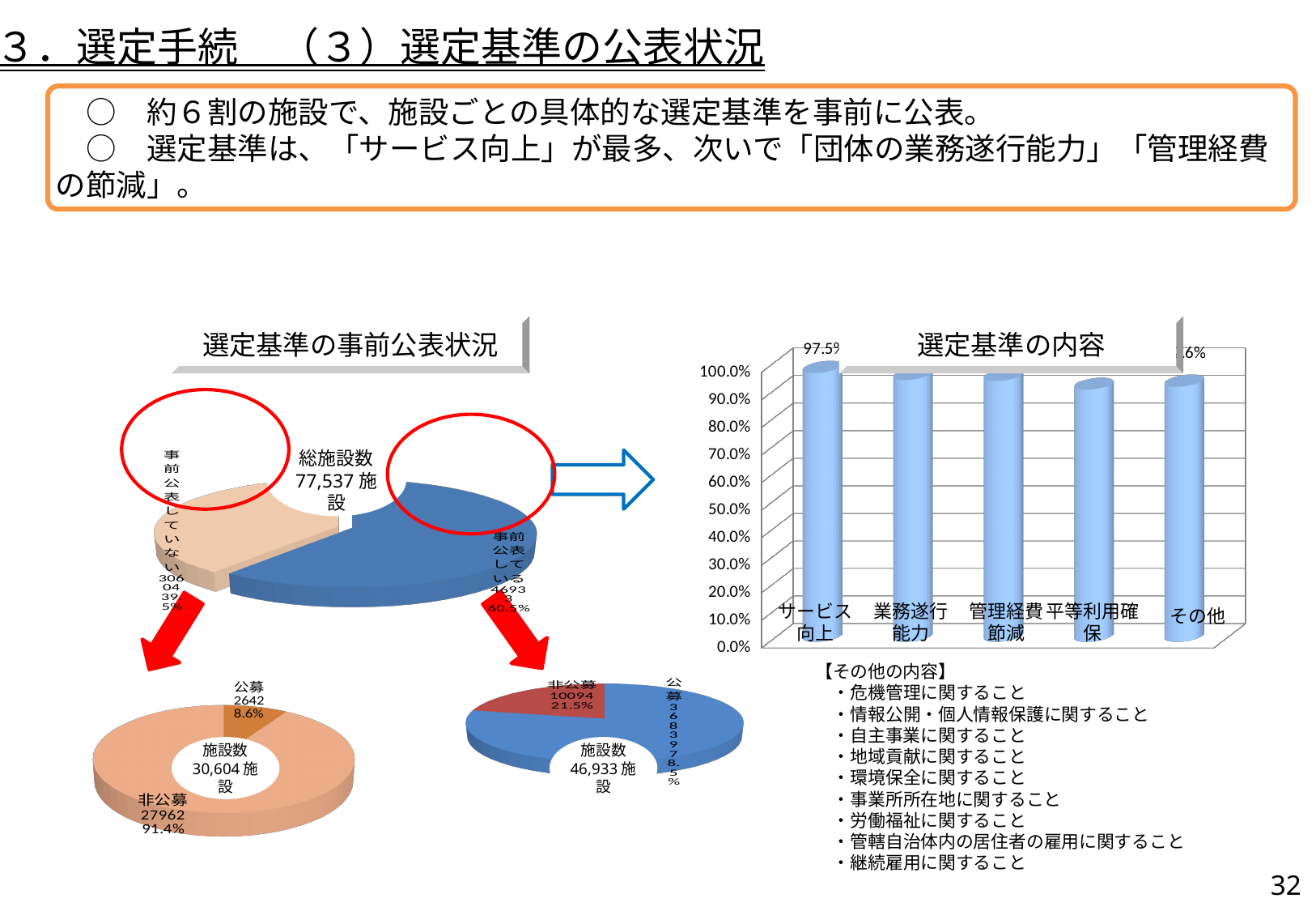
In the 選定基準の内容 chart, is the value for 業務遂行能力 greater or less than 90.0%? greater In the 選定基準の内容 chart, is the value for 平等利用確保 greater or less than 80.0%? greater In the 選定基準の事前公表状況 chart, what is the total number of facilities (総施設数) shown in the centre? 77,537 施設 In the bottom-left doughnut chart (施設数 30,604 施設), which slice is larger, 公募 or 非公募? 非公募 In the bottom-middle doughnut chart (施設数 46,933 施設), what is the difference between the 公募 count (36839) and the 非公募 count (10094)? 26745 In the 選定基準の内容 chart, what is the value for サービス向上? 97.5% In the bottom-middle doughnut chart (施設数 46,933 施設), what is the number of 非公募 facilities? 10094 What kind of chart is the 選定基準の内容 chart on the right? bar chart In the 選定基準の事前公表状況 chart, what percentage of facilities are 事前公表している? 60.5% How many categories are shown in the 選定基準の内容 bar chart? 5 In the bottom-left doughnut chart (施設数 30,604 施設), what share is 公募? 8.6% In the 選定基準の内容 chart, which category has the highest value? サービス向上